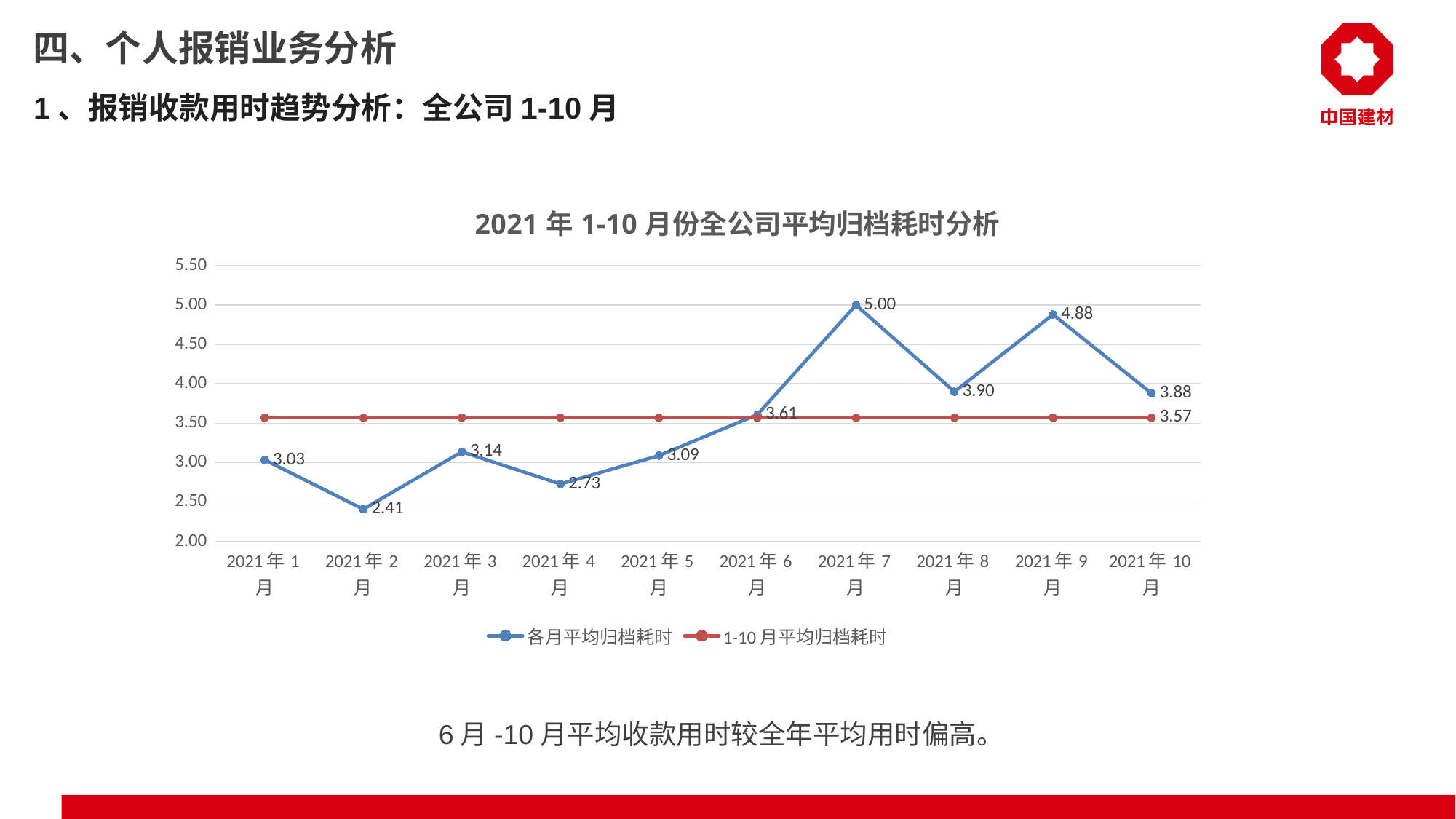
What is the value of 各月平均归档耗时 for 2021年7月? 5.00 What is the value of 1-10月平均归档耗时 shown on the chart? 3.57 How many months are plotted on the x axis? 10 Which is larger, the 各月平均归档耗时 for 2021年9月 or for 2021年10月? 2021年9月 What is the value of 各月平均归档耗时 for 2021年2月? 2.41 Which month has the lowest 各月平均归档耗时? 2021年2月 How many series does the legend list? 2 What is the difference between the 各月平均归档耗时 for 2021年7月 and 2021年8月? 1.10 What kind of chart is shown on the slide? line chart What is the title of the chart? 2021年1-10月份全公司平均归档耗时分析 Is the 各月平均归档耗时 for 2021年4月 greater or less than 3.00? less Which month has the highest 各月平均归档耗时? 2021年7月